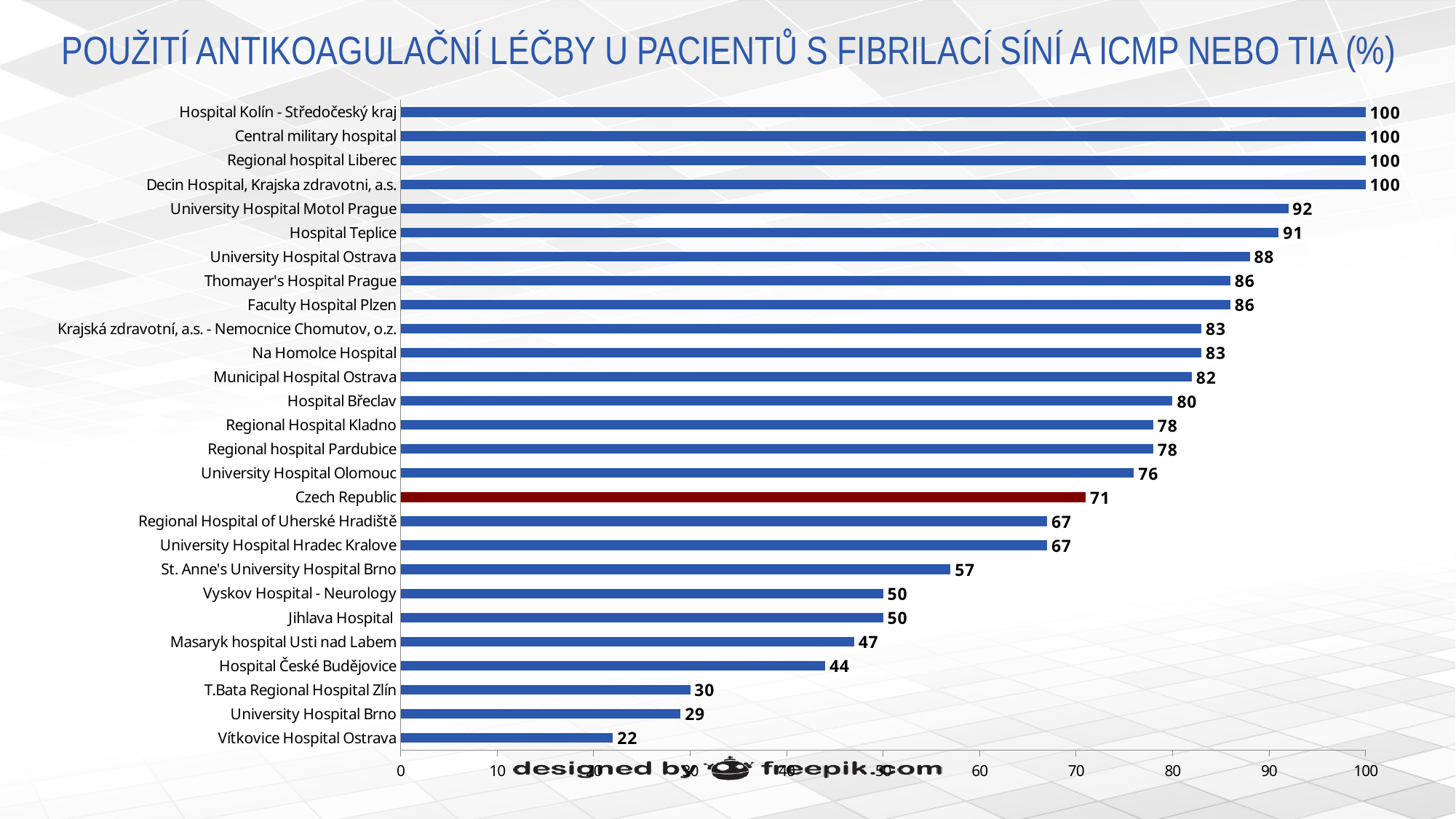
What is the value for Czech Republic? 71 How many hospitals have a value of 100? 4 What kind of chart is shown on the slide? bar chart Which bar is coloured differently (dark red) from the others? Czech Republic Which category has the lowest value? Vítkovice Hospital Ostrava How many categories are shown on the chart? 27 What is the value for University Hospital Motol Prague? 92 Which has a larger value, Regional Hospital Kladno or Hospital České Budějovice? Regional Hospital Kladno What is the value for St. Anne's University Hospital Brno? 57 What is the difference between the values for Hospital Teplice and University Hospital Brno? 62 What is the difference between the values for Czech Republic and Vítkovice Hospital Ostrava? 49 Is the value for Masaryk hospital Usti nad Labem greater or less than 50? less